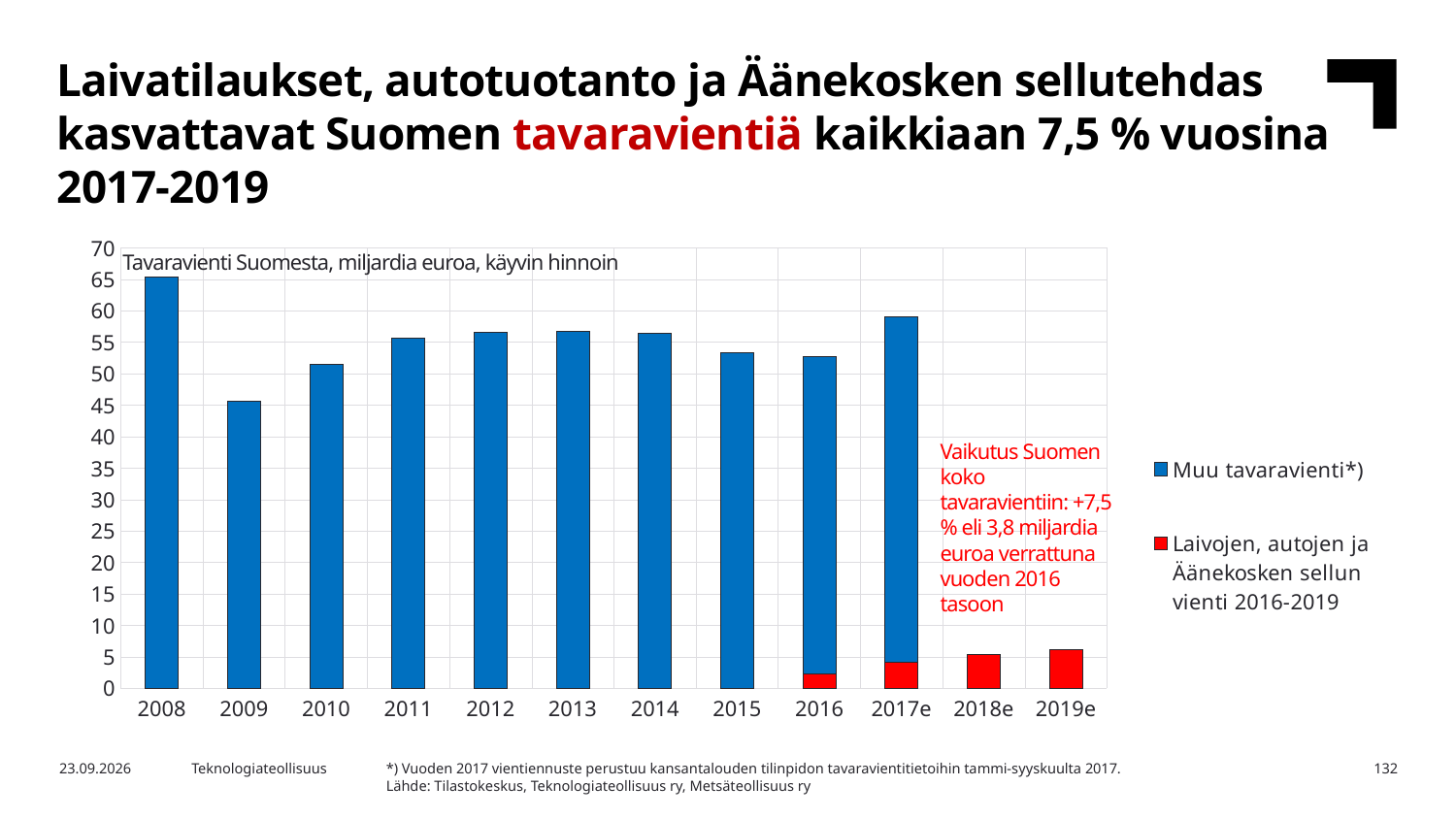
Among the years 2008 to 2017e, which year has the lowest total bar? 2009 Is the total value for 2017e greater or less than 55? greater Which series is shown in red in the chart legend? Laivojen, autojen ja Äänekosken sellun vienti 2016-2019 Did the goods export value rise or fall from 2008 to 2009? Fall What is the title printed inside the chart area? Tavaravienti Suomesta, miljardia euroa, käyvin hinnoin What kind of chart is shown on the slide? Stacked bar chart How many series does the chart legend list? 2 Is the value for 2008 greater or less than 60? greater Is the value for 2009 greater or less than 50? less Which year has the highest total goods export value in the chart? 2008 How many year categories are shown on the x axis of the chart? 12 Which year has a larger total bar, 2010 or 2011? 2011